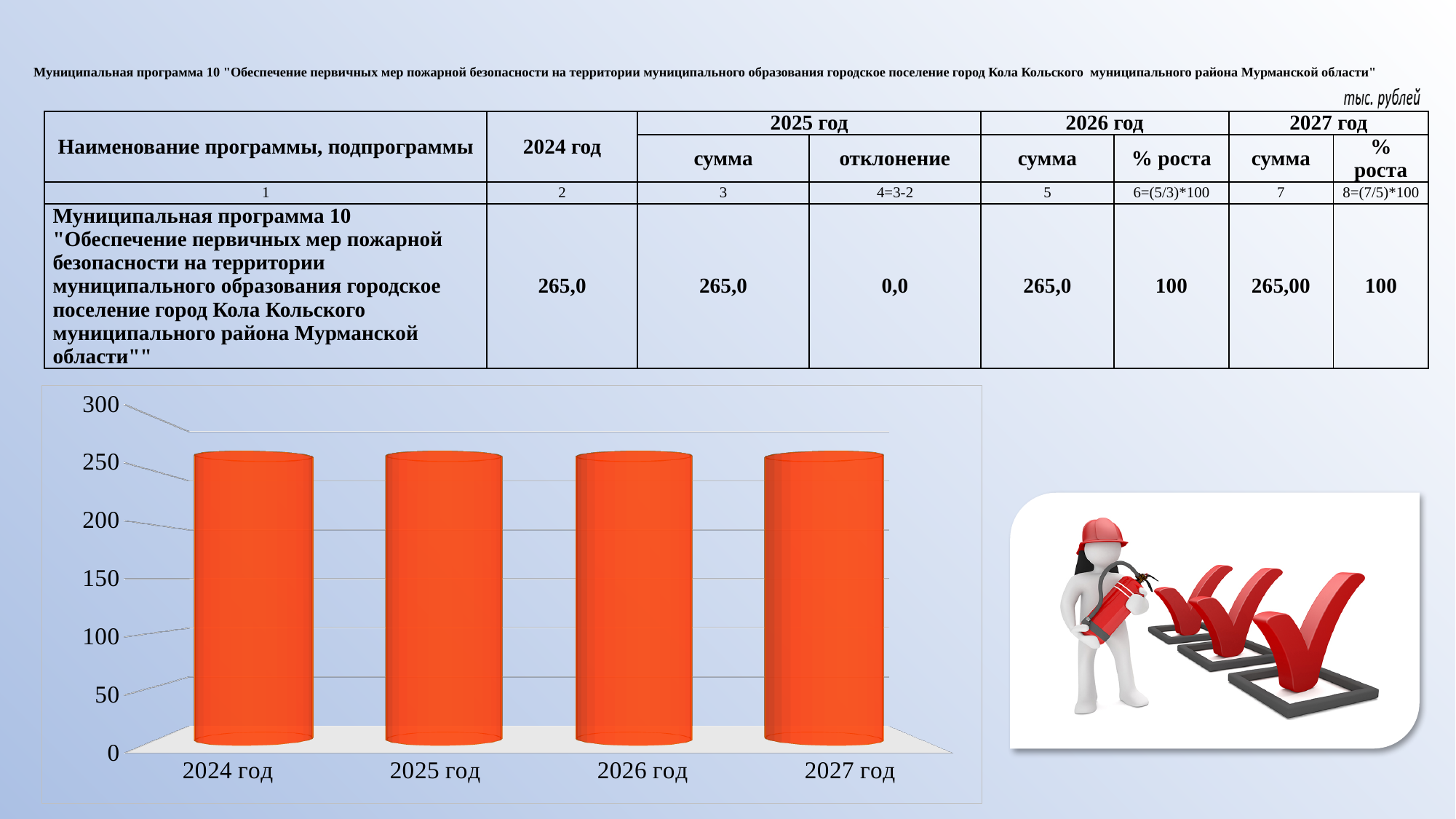
What colour are the bars in the chart? orange Is the value for 2025 год greater or less than 300? less Do the values rise, fall or stay the same from 2024 год to 2027 год? stay the same How many categories are shown on the x axis of the chart? 4 What kind of chart is shown on the slide? bar chart Is the value for 2027 год greater or less than 300? less Is the value for 2024 год greater or less than 200? greater What is the highest tick value shown on the vertical axis? 300 What is the label of the first category on the x axis? 2024 год